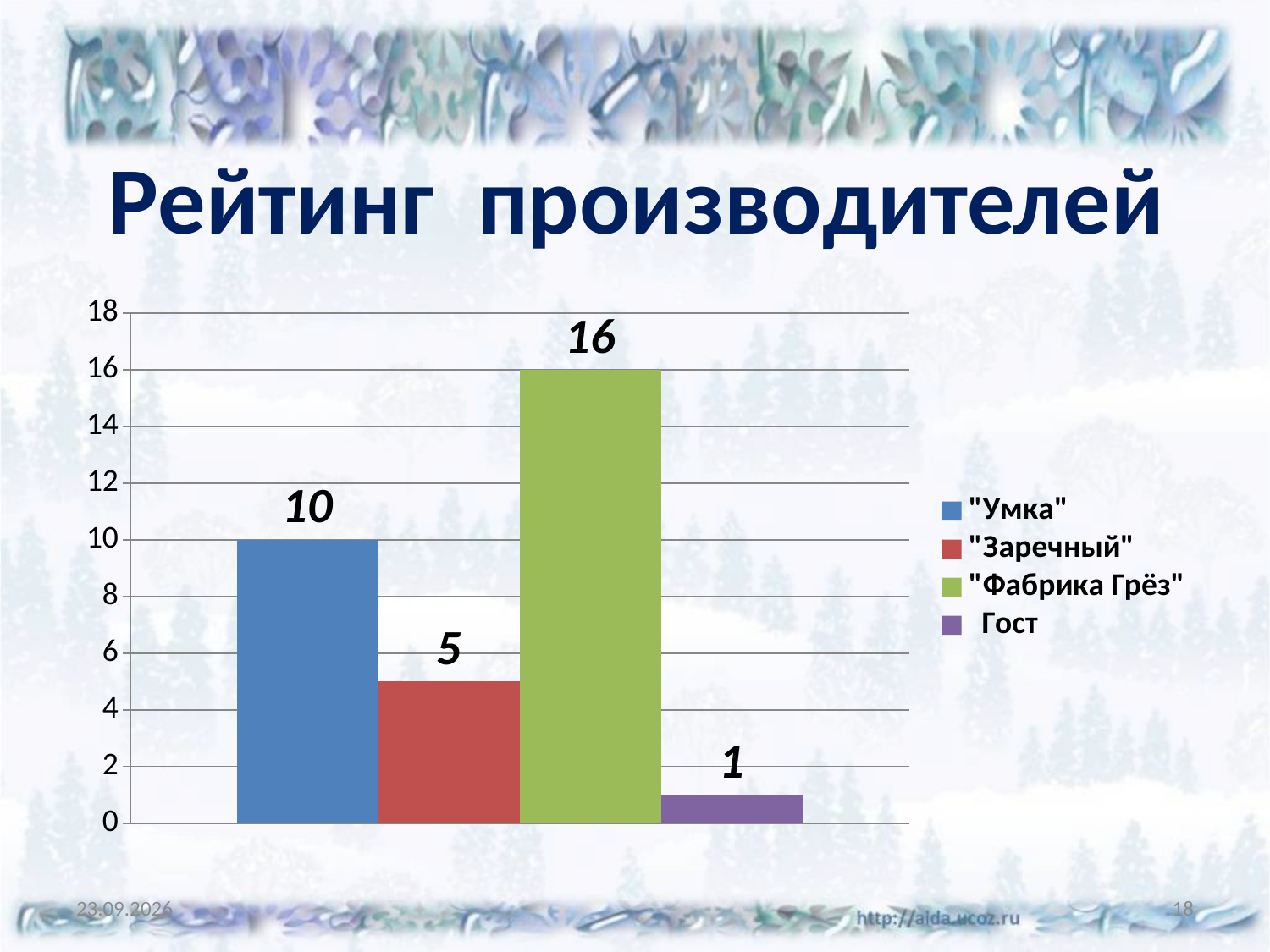
Which is larger, the value for "Умка" or the value for "Заречный"? "Умка" What is the value for Гост? 1 Which series has the lowest value? Гост Is the value for "Фабрика Грёз" greater or less than 14? greater What kind of chart is shown on the slide? bar chart How many series does the legend list? 4 What is the difference between the values for "Фабрика Грёз" and "Умка"? 6 What is the title of the slide? Рейтинг производителей What is the value for "Фабрика Грёз"? 16 What is the value for "Заречный"? 5 What is the value for "Умка"? 10 Which series has the highest value? "Фабрика Грёз"